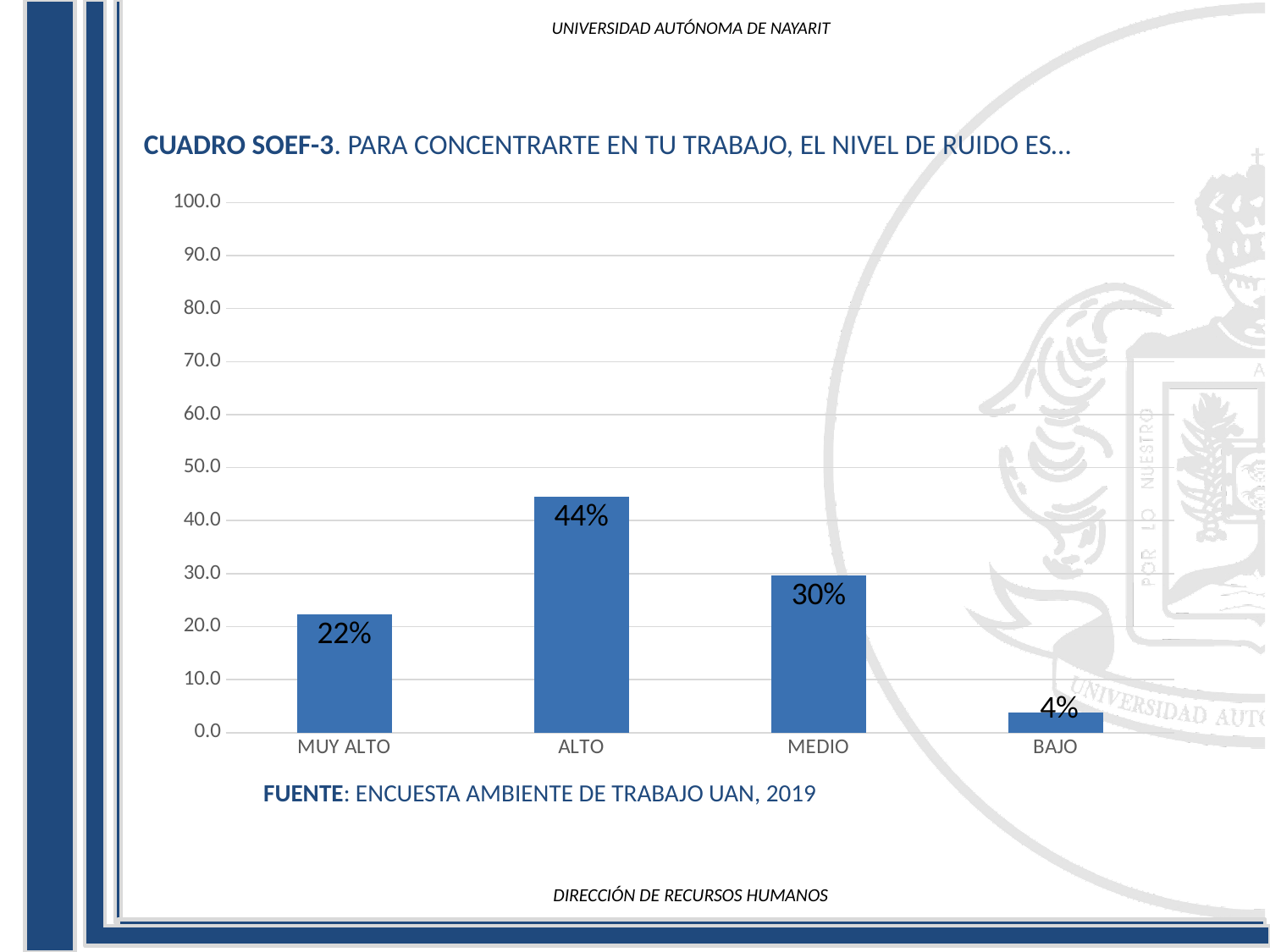
What is the value for ALTO? 44% Which is larger, the value for MUY ALTO or the value for MEDIO? MEDIO What kind of chart is shown on the slide? bar chart What is the difference between the values for ALTO and MEDIO? 14% What is the value for BAJO? 4% What is the value for MEDIO? 30% How many categories are shown on the x axis? 4 Which category has the lowest value? BAJO What is the value for MUY ALTO? 22% Which category has the highest value? ALTO Is the value for ALTO greater or less than 40.0? greater What source is cited below the chart? ENCUESTA AMBIENTE DE TRABAJO UAN, 2019